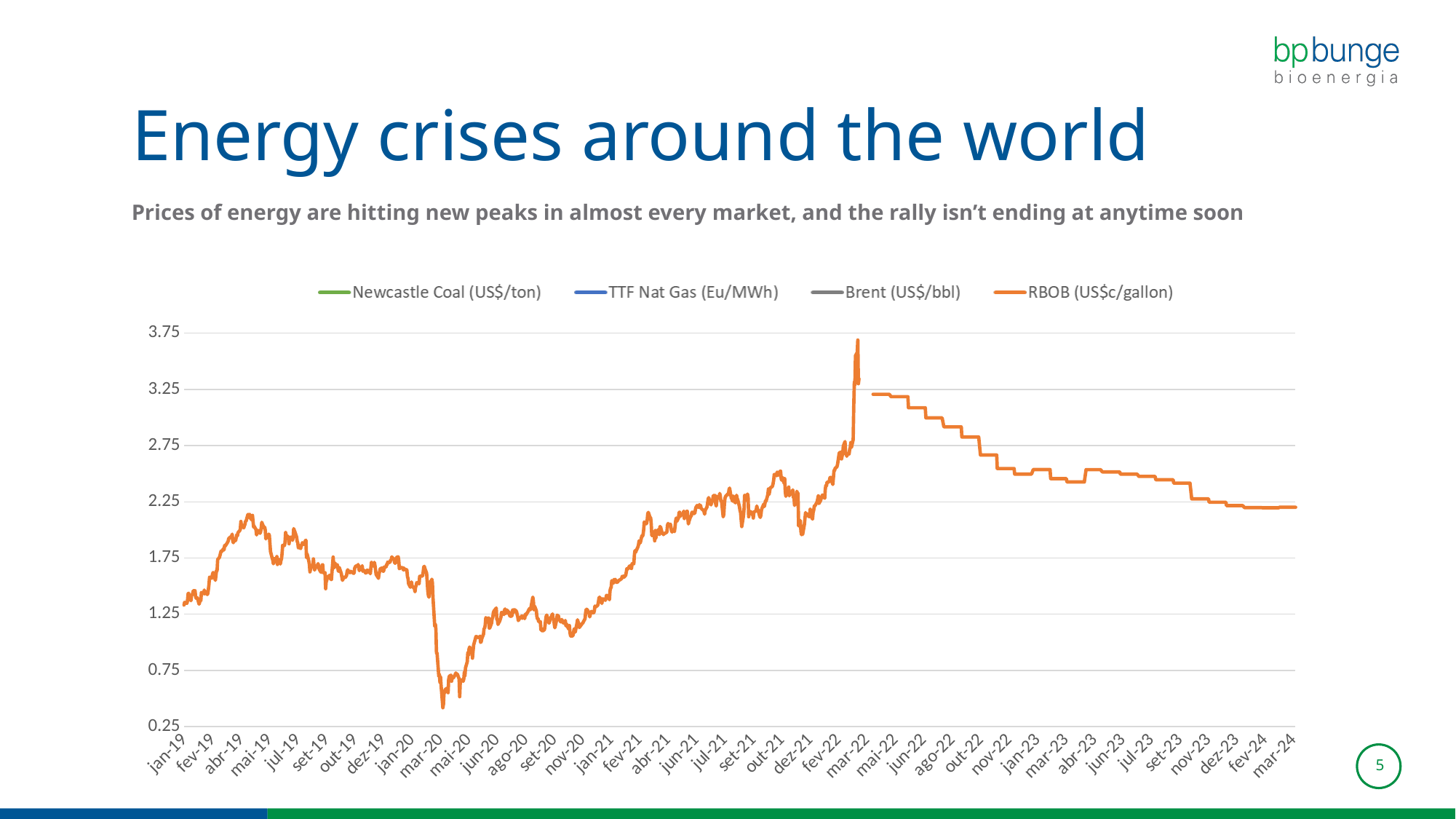
Is the RBOB value at jan-19 greater or less than 1.75? less What kind of chart is shown on the slide? line chart What is the title of the slide containing the chart? Energy crises around the world Is the lowest value of the RBOB line in 2020 greater or less than 0.75? less Around which x-axis label does the RBOB line reach its highest point? mar-22 How many series does the legend list? 4 Is the RBOB value at mar-24 greater or less than 2.75? less Which series is plotted in orange? RBOB (US$c/gallon) In which year does the RBOB line reach its lowest point? 2020 Does the RBOB line rise or fall between mai-22 and mar-24? fall